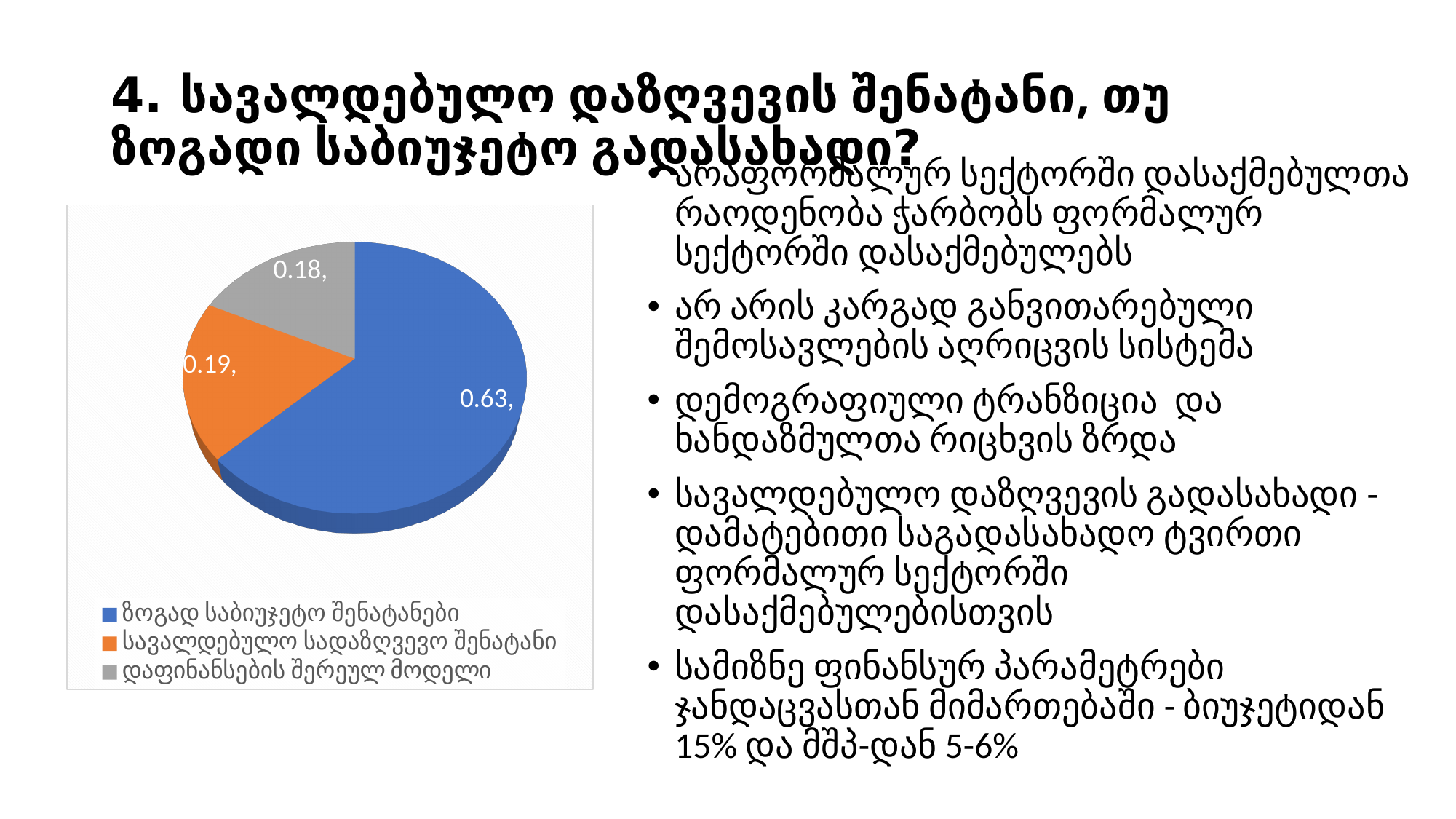
What is the difference between the values for ზოგად საბიუჯეტო შენატანები and დაფინანსების შერეულ მოდელი? 0.45 Which colour represents ზოგად საბიუჯეტო შენატანები in the pie chart? blue What value is shown for the slice labelled სავალდებულო სადაზღვევო შენატანი? 0.19 Which colour represents დაფინანსების შერეულ მოდელი in the pie chart? gray Is the value for ზოგად საბიუჯეტო შენატანები greater or less than 0.5? greater How many entries does the legend of the pie chart list? 3 What value is shown for the slice labelled ზოგად საბიუჯეტო შენატანები? 0.63 What is the difference between the values for ზოგად საბიუჯეტო შენატანები and სავალდებულო სადაზღვევო შენატანი? 0.44 How many slices does the pie chart have? 3 Which slice of the pie chart is the largest? ზოგად საბიუჯეტო შენატანები What kind of chart is shown on the slide? pie chart What value is shown for the slice labelled დაფინანსების შერეულ მოდელი? 0.18